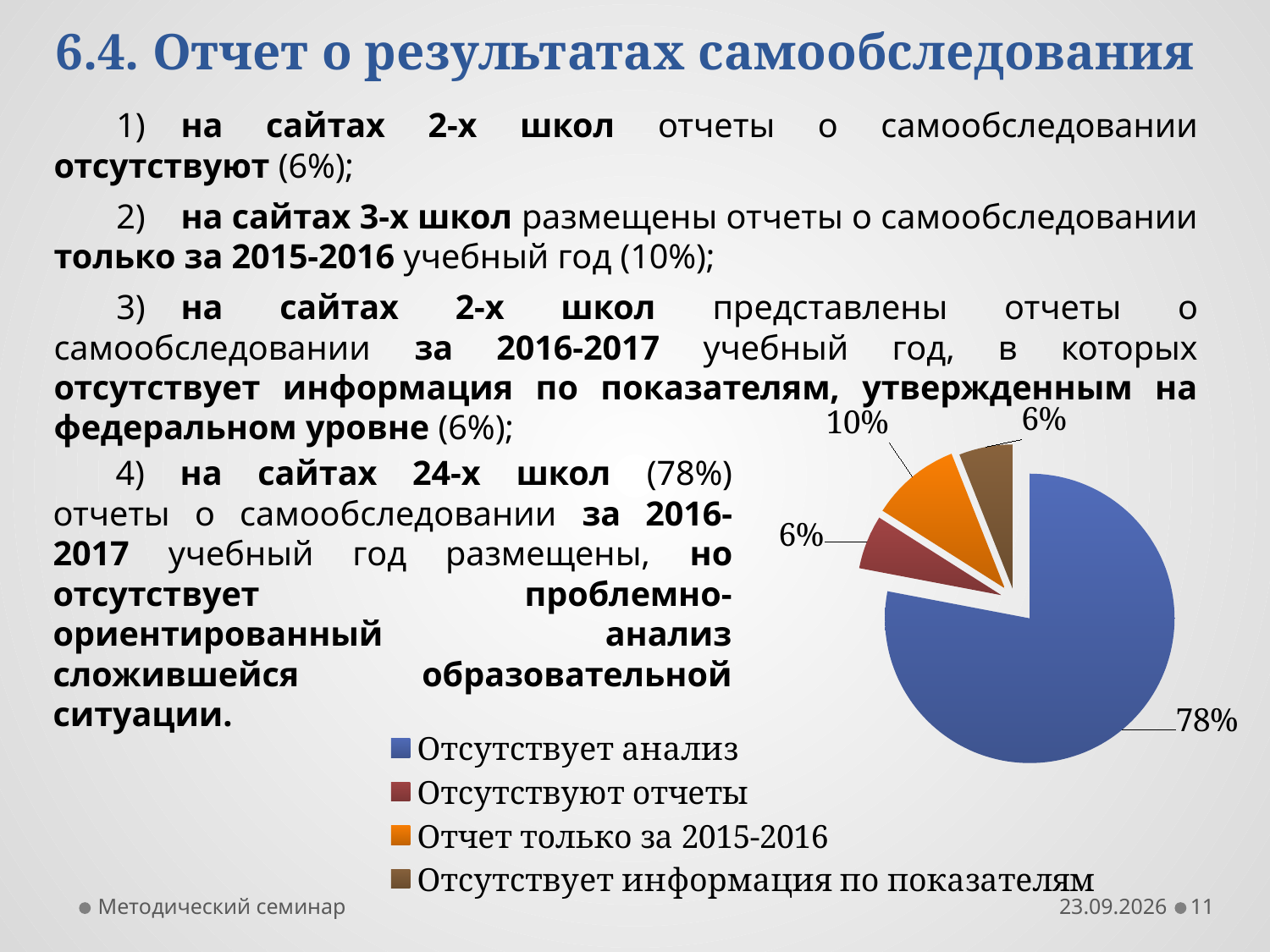
How many slices does the pie chart have? 4 What is the difference between the shares of "Отсутствует анализ" and "Отчет только за 2015-2016"? 68% Which category has the largest slice of the pie? Отсутствует анализ What share of the pie does "Отчет только за 2015-2016" have? 10% Which is larger: the share for "Отчет только за 2015-2016" or the share for "Отсутствуют отчеты"? Отчет только за 2015-2016 How many entries does the legend list? 4 What kind of chart is shown on the slide? pie chart What is the smallest percentage shown on the pie chart? 6% What share of the pie does "Отсутствует информация по показателям" have? 6% What share of the pie does "Отсутствуют отчеты" have? 6% What colour is the slice for "Отчет только за 2015-2016"? orange